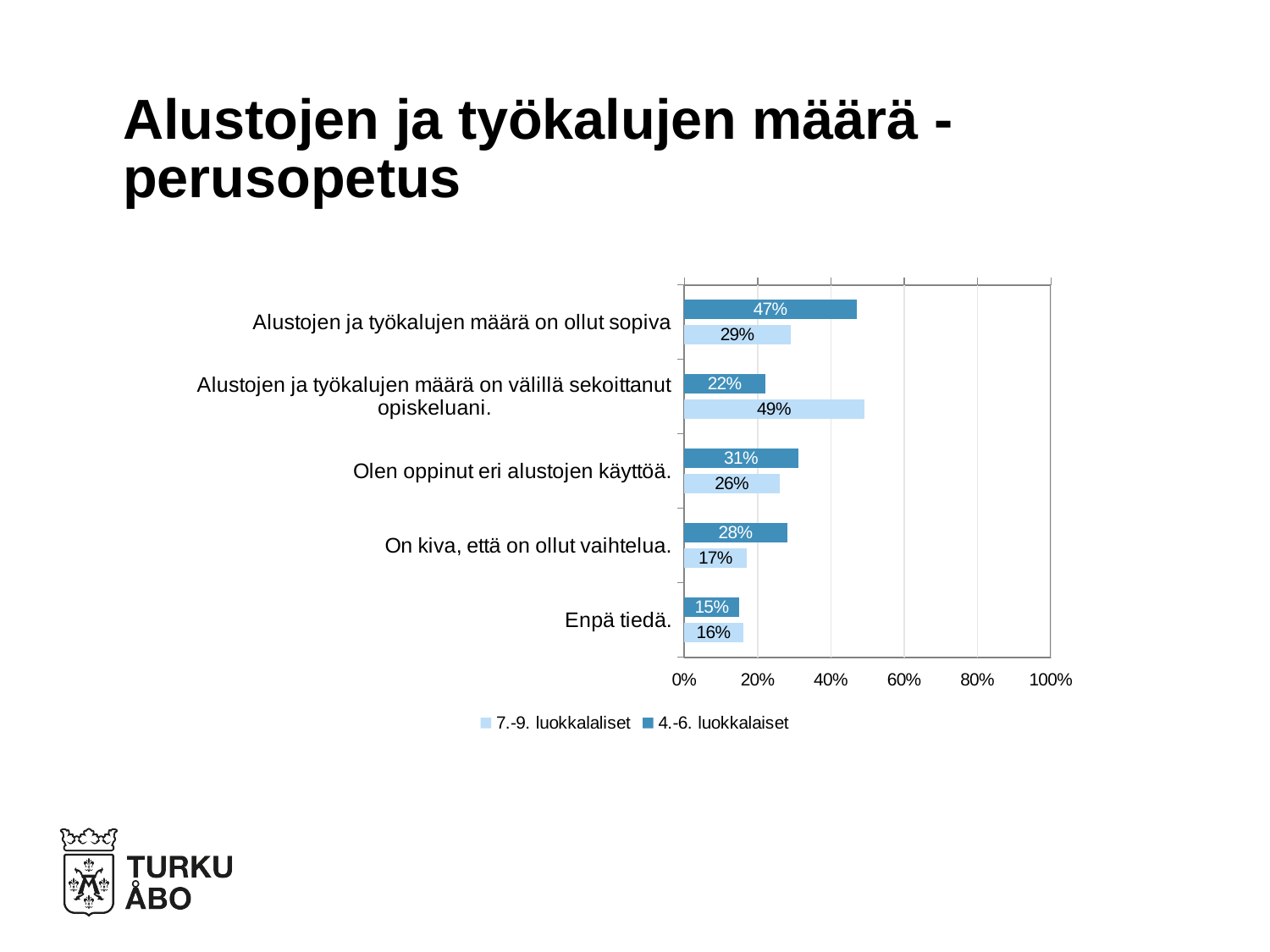
Which category has the highest value for 4.-6. luokkalaiset? Alustojen ja työkalujen määrä on ollut sopiva What is the value for 4.-6. luokkalaiset for "Alustojen ja työkalujen määrä on ollut sopiva"? 47% What is the value for 7.-9. luokkalaliset for "Alustojen ja työkalujen määrä on välillä sekoittanut opiskeluani."? 49% How many series does the legend list? 2 Which category has the lowest value for 7.-9. luokkalaliset? Enpä tiedä. What is the difference between the 4.-6. luokkalaiset and 7.-9. luokkalaliset values for "Olen oppinut eri alustojen käyttöä."? 5% What kind of chart is shown on the slide? bar chart What is the value for 7.-9. luokkalaliset for "On kiva, että on ollut vaihtelua."? 17% For "Alustojen ja työkalujen määrä on välillä sekoittanut opiskeluani.", which series has the larger value? 7.-9. luokkalaliset Which series is shown in the darker blue colour? 4.-6. luokkalaiset Is the value for 4.-6. luokkalaiset for "On kiva, että on ollut vaihtelua." greater or less than 40%? less How many categories are shown on the chart? 5